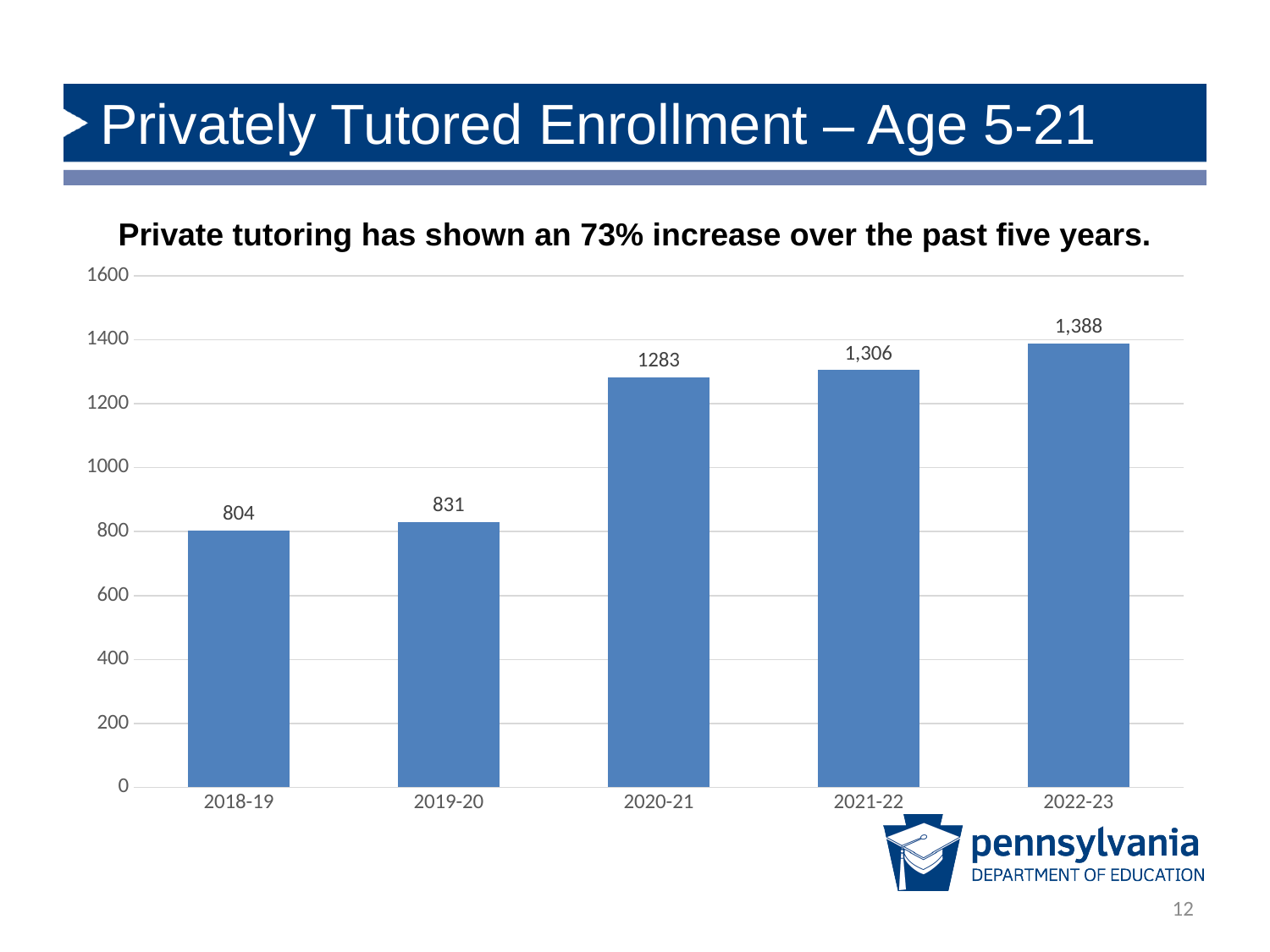
Is the enrollment value for 2019-20 greater or less than 1000? less Which school year has the highest privately tutored enrollment? 2022-23 Which year has a larger enrollment, 2020-21 or 2021-22? 2021-22 What is the privately tutored enrollment value for 2018-19? 804 What is the privately tutored enrollment value for 2022-23? 1,388 What is the difference in enrollment between 2022-23 and 2021-22? 82 Do the enrollment values rise or fall from 2018-19 to 2022-23? Rise How many school years are shown on the chart? 5 What is the difference in enrollment between 2019-20 and 2018-19? 27 Which school year has the lowest privately tutored enrollment? 2018-19 What kind of chart is shown on the slide? Bar chart What is the privately tutored enrollment value for 2020-21? 1283